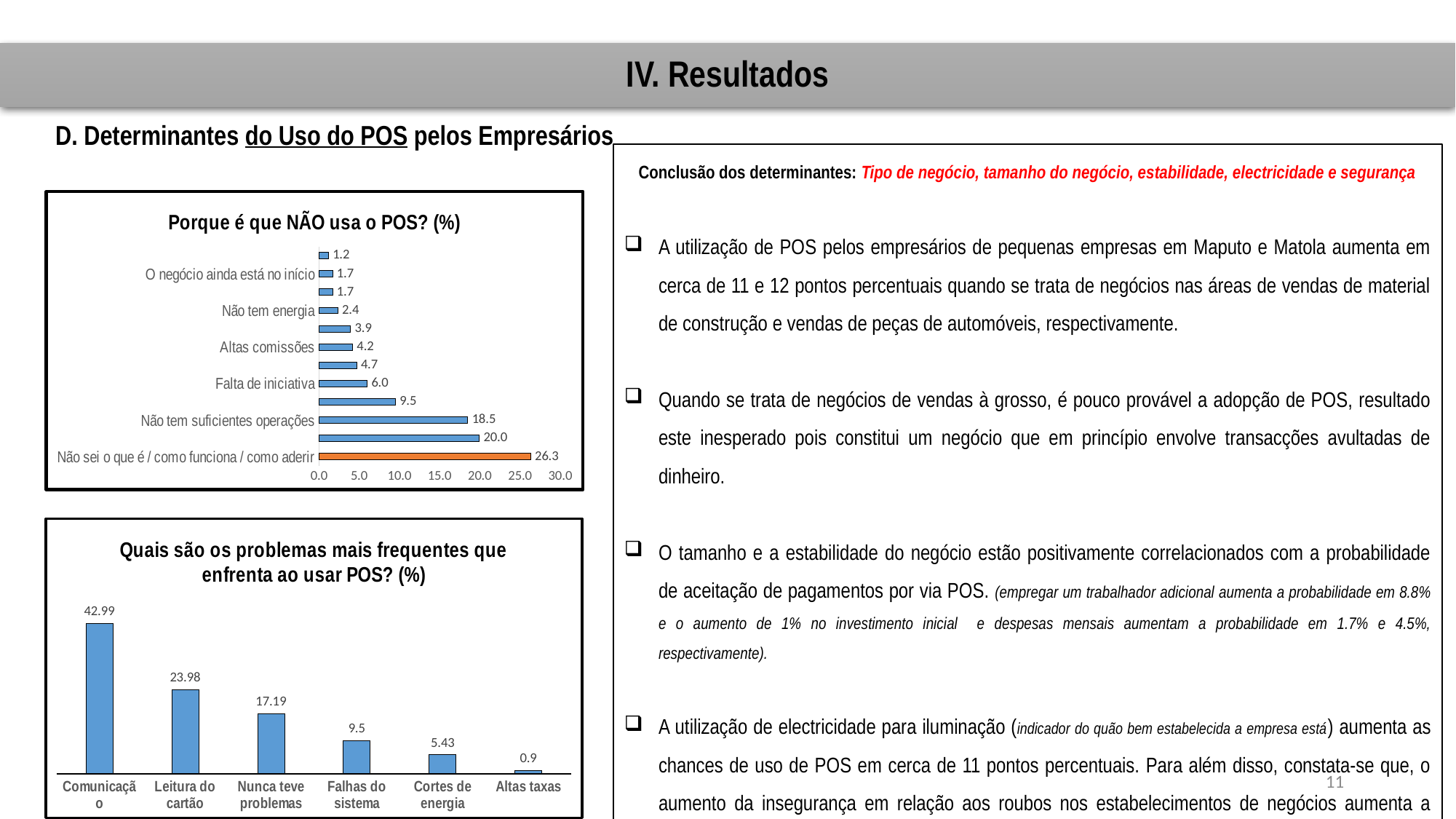
In the chart 'Quais são os problemas mais frequentes que enfrenta ao usar POS? (%)', what is the value for 'Cortes de energia'? 5.43 In the chart 'Porque é que NÃO usa o POS? (%)', what is the value for 'Altas comissões'? 4.2 In the chart 'Porque é que NÃO usa o POS? (%)', what is the value for 'Não tem suficientes operações'? 18.5 In the chart 'Quais são os problemas mais frequentes que enfrenta ao usar POS? (%)', how many categories are shown? 6 In the chart 'Quais são os problemas mais frequentes que enfrenta ao usar POS? (%)', what is the value for 'Comunicação'? 42.99 In the chart 'Porque é que NÃO usa o POS? (%)', which is larger: 'Falta de iniciativa' or 'Não tem energia'? Falta de iniciativa In the chart 'Quais são os problemas mais frequentes que enfrenta ao usar POS? (%)', which category has the lowest value? Altas taxas In the chart 'Quais são os problemas mais frequentes que enfrenta ao usar POS? (%)', what is the difference between 'Leitura do cartão' and 'Nunca teve problemas'? 6.79 In the chart 'Porque é que NÃO usa o POS? (%)', which labelled category has the highest value? Não sei o que é / como funciona / como aderir In the chart 'Porque é que NÃO usa o POS? (%)', which bar is shown in a different colour (orange) from the others? Não sei o que é / como funciona / como aderir In the chart 'Porque é que NÃO usa o POS? (%)', what is the value for 'Não sei o que é / como funciona / como aderir'? 26.3 In the chart 'Porque é que NÃO usa o POS? (%)', what is the difference between 'Não sei o que é / como funciona / como aderir' and 'Não tem suficientes operações'? 7.8